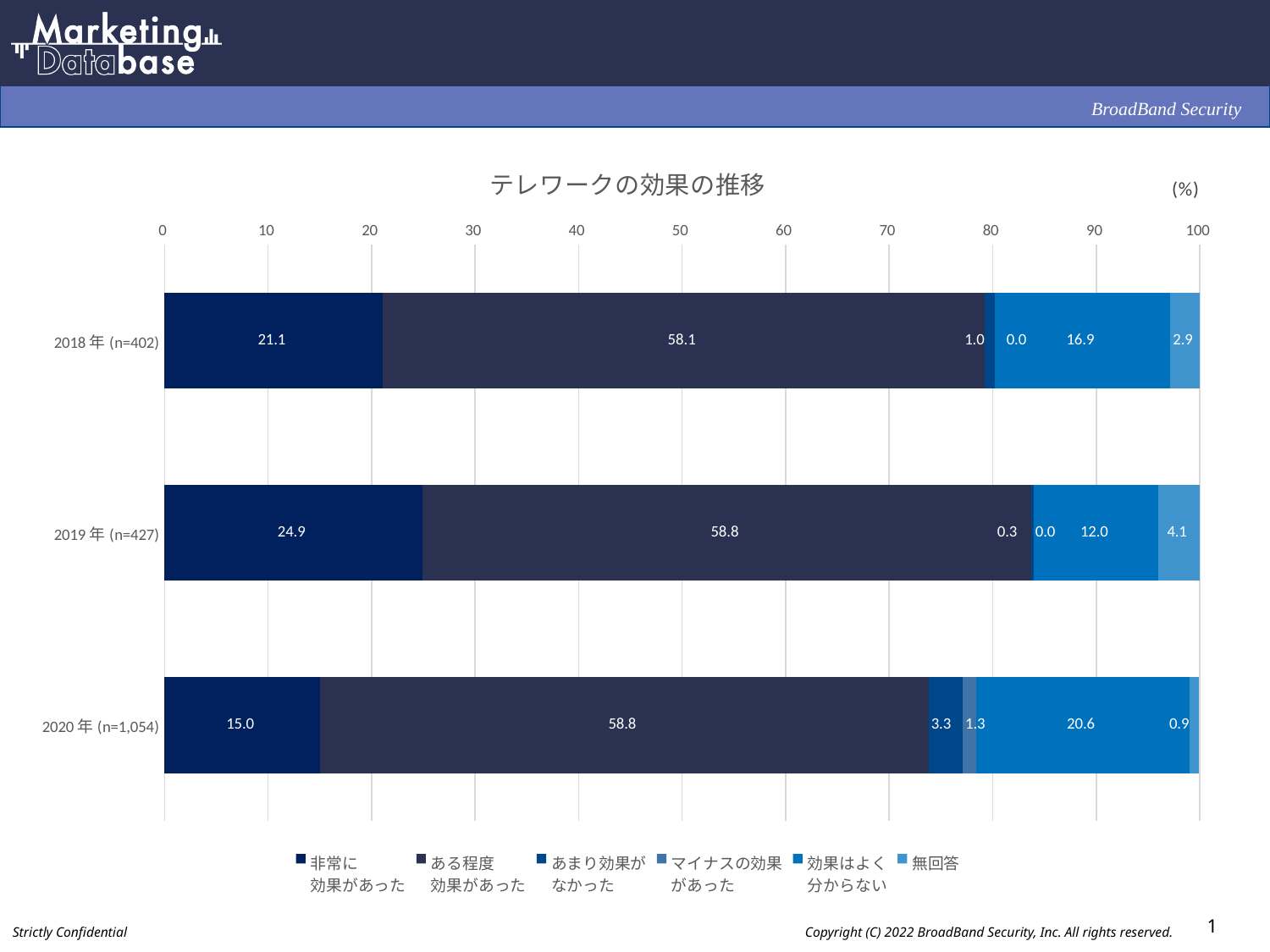
What is the value of 効果はよく分からない for 2020年 (n=1,054)? 20.6 Which is larger: the あまり効果がなかった value for 2020年 (n=1,054) or for 2018年 (n=402)? 2020年 (n=1,054) How many series does the legend list? 6 Which year has the highest value for 非常に効果があった? 2019年 (n=427) What is the title of the chart? テレワークの効果の推移 Which year has the lowest value for 効果はよく分からない? 2019年 (n=427) How many categories (years) are plotted on the chart? 3 What is the difference between the 非常に効果があった values for 2019年 (n=427) and 2020年 (n=1,054)? 9.9 What type of chart is shown on the slide? Stacked bar chart What is the value of 非常に効果があった for 2019年 (n=427)? 24.9 What is the value of マイナスの効果があった for 2020年 (n=1,054)? 1.3 What is the value of 無回答 for 2018年 (n=402)? 2.9